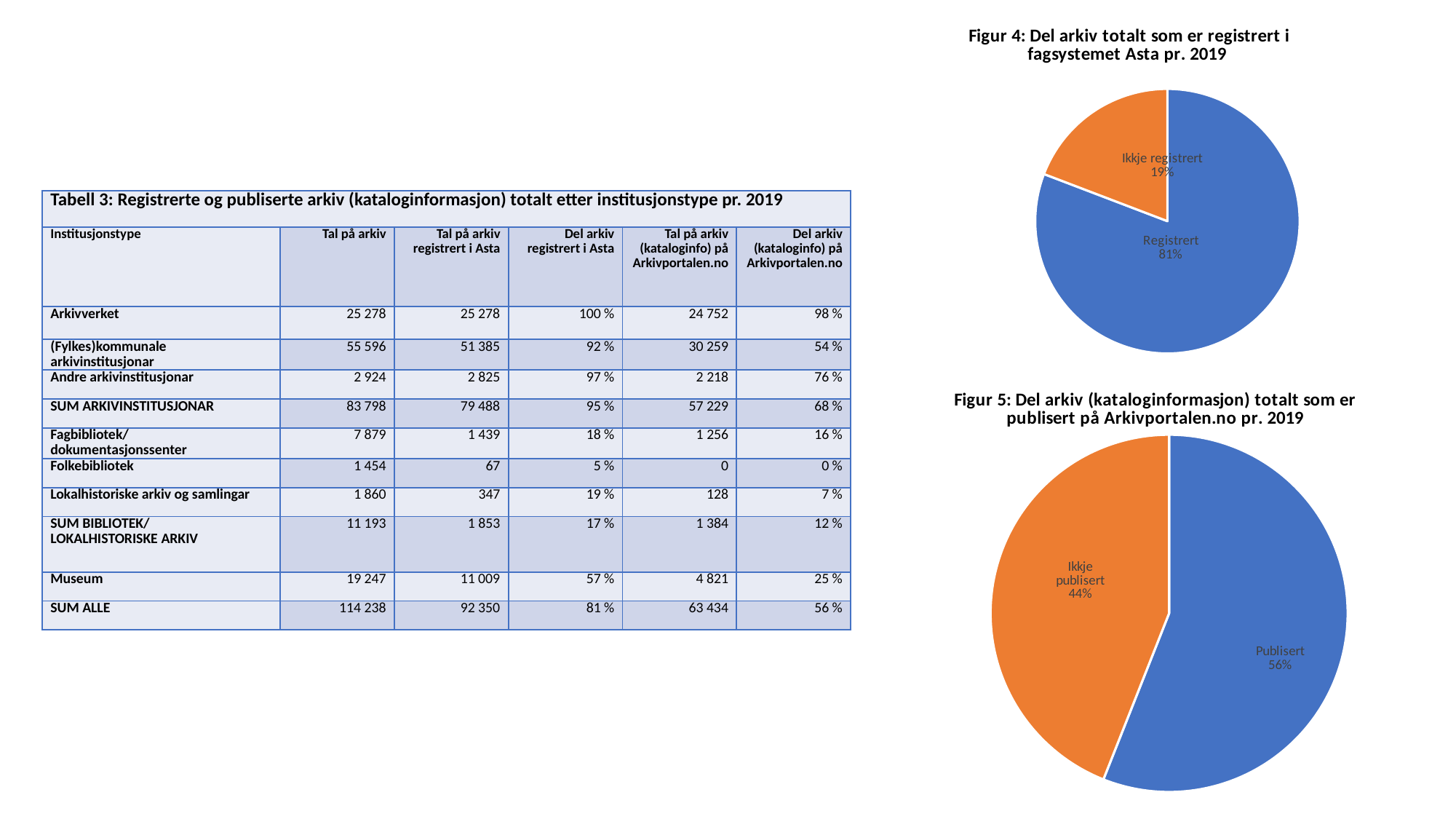
In Figur 5, which is larger, the Publisert slice or the Ikkje publisert slice? Publisert In Figur 5, what is the difference in percentage points between the Publisert and Ikkje publisert slices? 12 In Figur 5, what share of the pie is labelled Ikkje publisert? 44% In Figur 4, what share of the pie is labelled Ikkje registrert? 19% In Figur 4, which slice is the smallest? Ikkje registrert In Figur 4, what share of the pie is labelled Registrert? 81% In Figur 4, what is the difference in percentage points between the Registrert and Ikkje registrert slices? 62 In Figur 4, how many slices does the pie have? 2 What kind of chart is Figur 5? Pie chart In Figur 5, what colour is the Ikkje publisert slice? Orange In Figur 4, which slice is the largest? Registrert